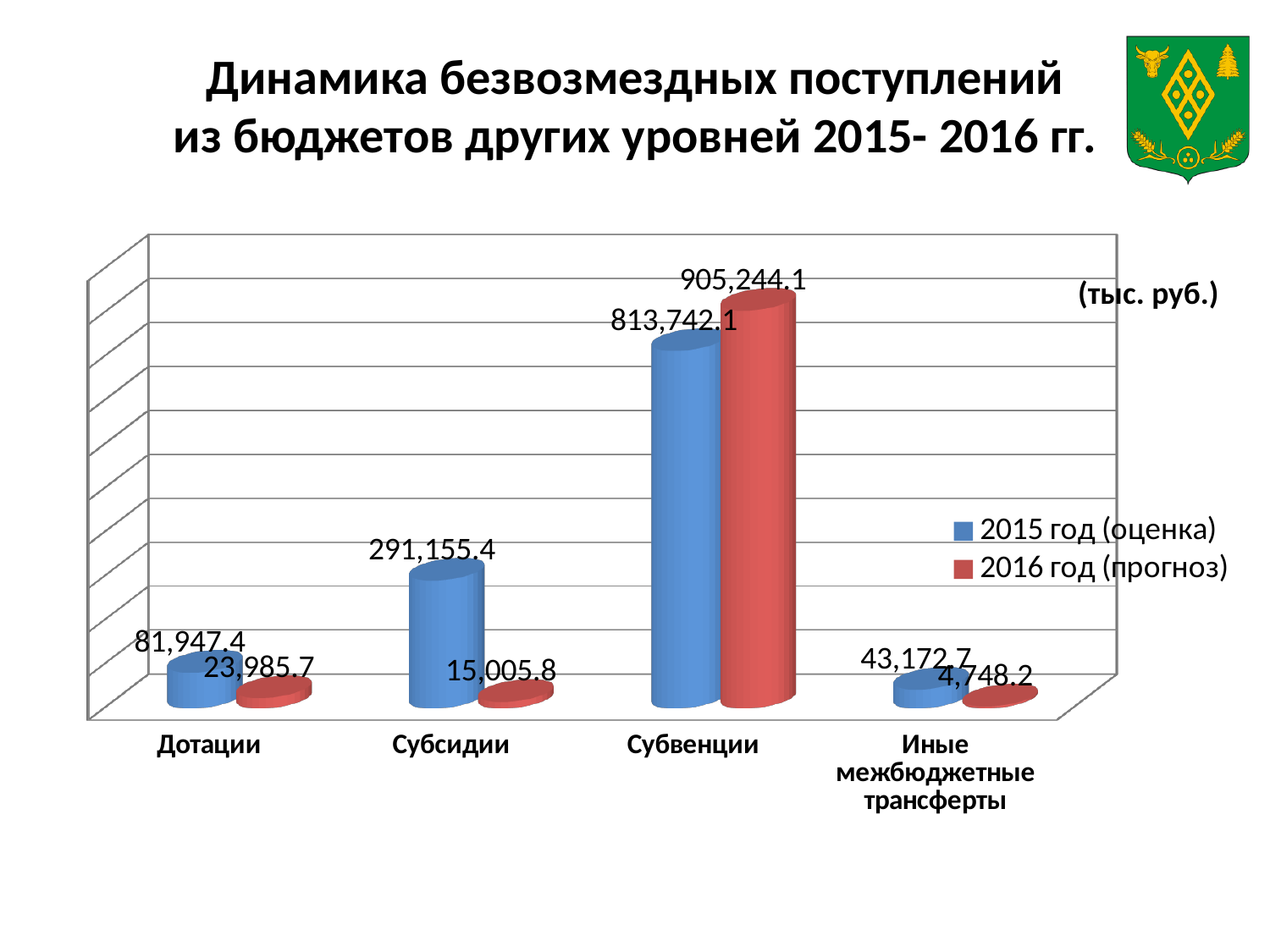
What is the value for Субсидии in the 2016 год (прогноз) series? 15,005.8 What is the difference between the 2016 год (прогноз) and 2015 год (оценка) values for Субвенции? 91,502.0 How many series does the legend list? 2 What is the difference between the 2015 год (оценка) and 2016 год (прогноз) values for Дотации? 57,961.7 What is the value for Иные межбюджетные трансферты in the 2015 год (оценка) series? 43,172.7 What is the value for Субвенции in the 2016 год (прогноз) series? 905,244.1 How many categories are shown on the x axis? 4 Which category has the highest value in the 2015 год (оценка) series? Субвенции What kind of chart is shown on the slide? Bar chart What is the value for Дотации in the 2015 год (оценка) series? 81,947.4 Which category has the lowest value in the 2016 год (прогноз) series? Иные межбюджетные трансферты Which is larger for Субсидии: the 2015 год (оценка) value or the 2016 год (прогноз) value? 2015 год (оценка)